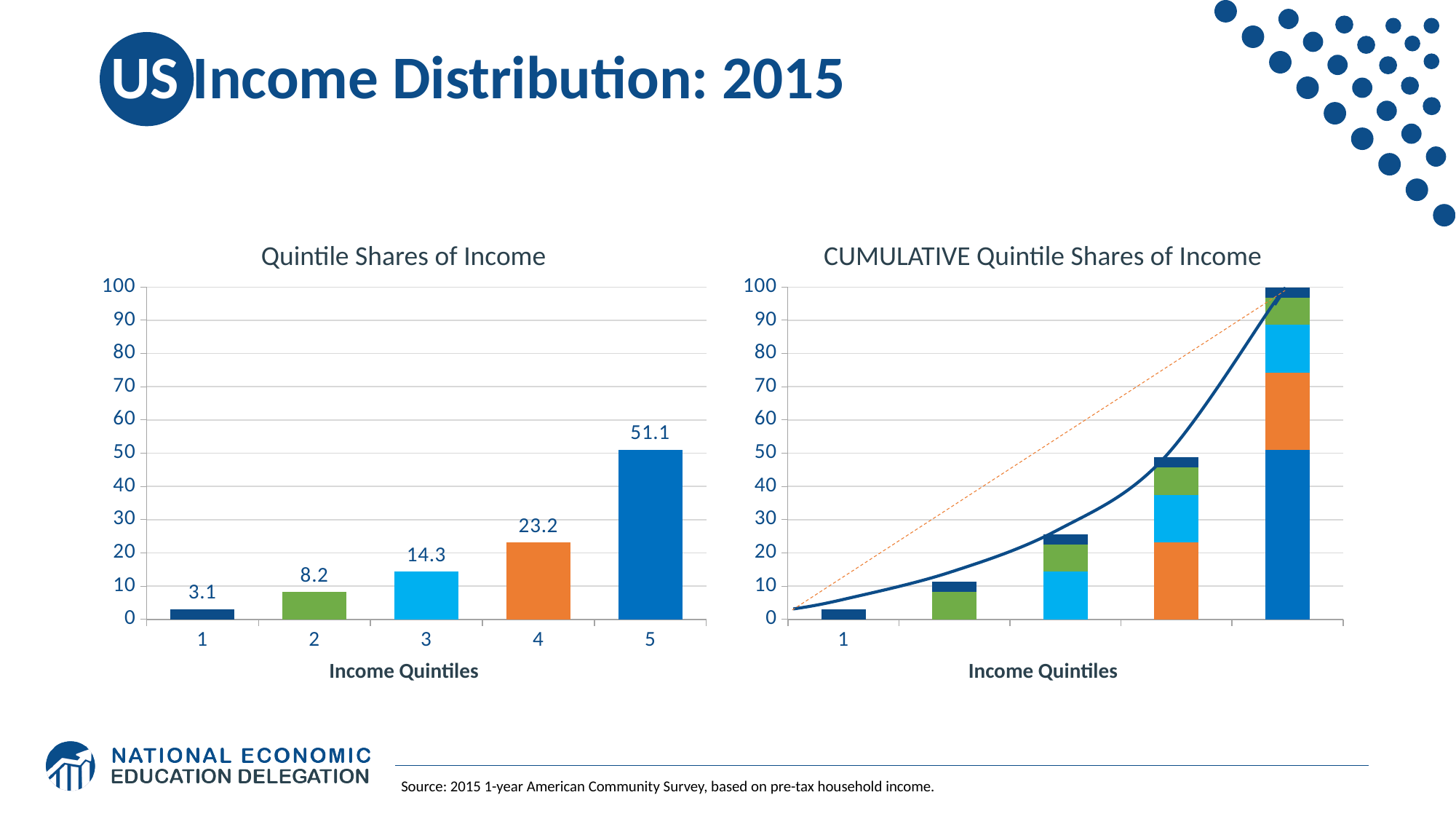
In the 'Quintile Shares of Income' chart, how many income quintiles are plotted? 5 In the 'Quintile Shares of Income' chart, do the values rise or fall as the quintile number increases? rise What kind of chart is the 'Quintile Shares of Income' chart on the left? bar chart In the 'Quintile Shares of Income' chart, what is the value for income quintile 3? 14.3 In the 'Quintile Shares of Income' chart, what is the value for income quintile 5? 51.1 In the 'Quintile Shares of Income' chart, what is the difference between the values for quintile 2 and quintile 1? 5.1 In the 'Quintile Shares of Income' chart, which income quintile has the highest share? 5 In the 'Quintile Shares of Income' chart, which is larger, the value for quintile 4 or the value for quintile 3? quintile 4 In the 'Quintile Shares of Income' chart, what is the value for income quintile 1? 3.1 In the 'Quintile Shares of Income' chart, which income quintile has the lowest share? 1 In the 'Quintile Shares of Income' chart, what is the difference between the values for quintile 5 and quintile 4? 27.9 In the 'CUMULATIVE Quintile Shares of Income' chart, is the total of the tallest stacked bar greater or less than 90? greater